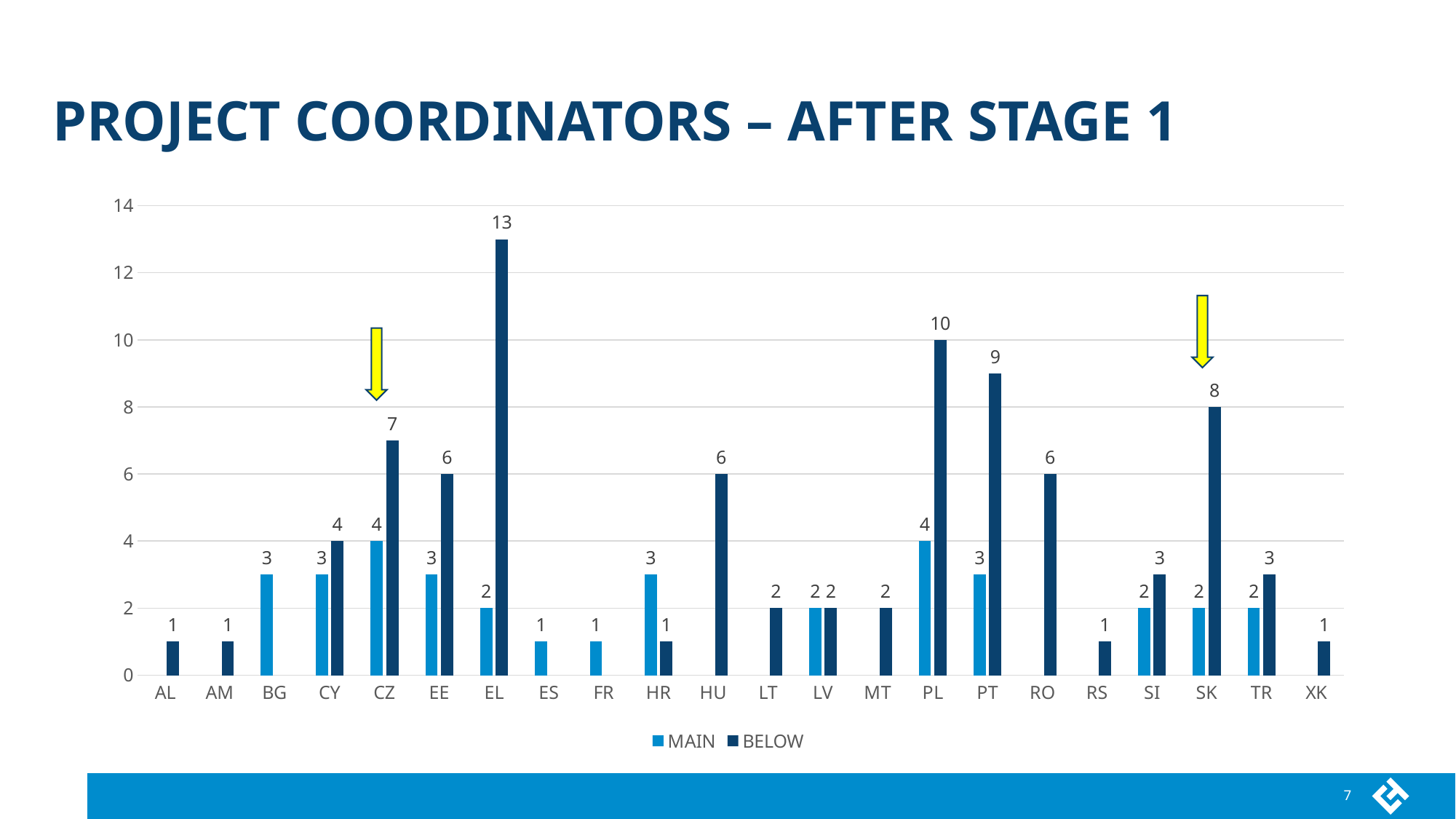
What is the BELOW value for EL? 13 What is the title of the slide? PROJECT COORDINATORS – AFTER STAGE 1 What is the difference between the BELOW and MAIN values for PL? 6 Which is larger for SK, the MAIN value or the BELOW value? BELOW How many series does the legend list? 2 What kind of chart is shown on the slide? bar chart Is the BELOW value for EL greater or less than 12? greater Which country has the highest BELOW value? EL What is the MAIN value for CZ? 4 What is the BELOW value for PT? 9 Which series is shown in the darker blue colour? BELOW How many countries are shown on the x axis? 22